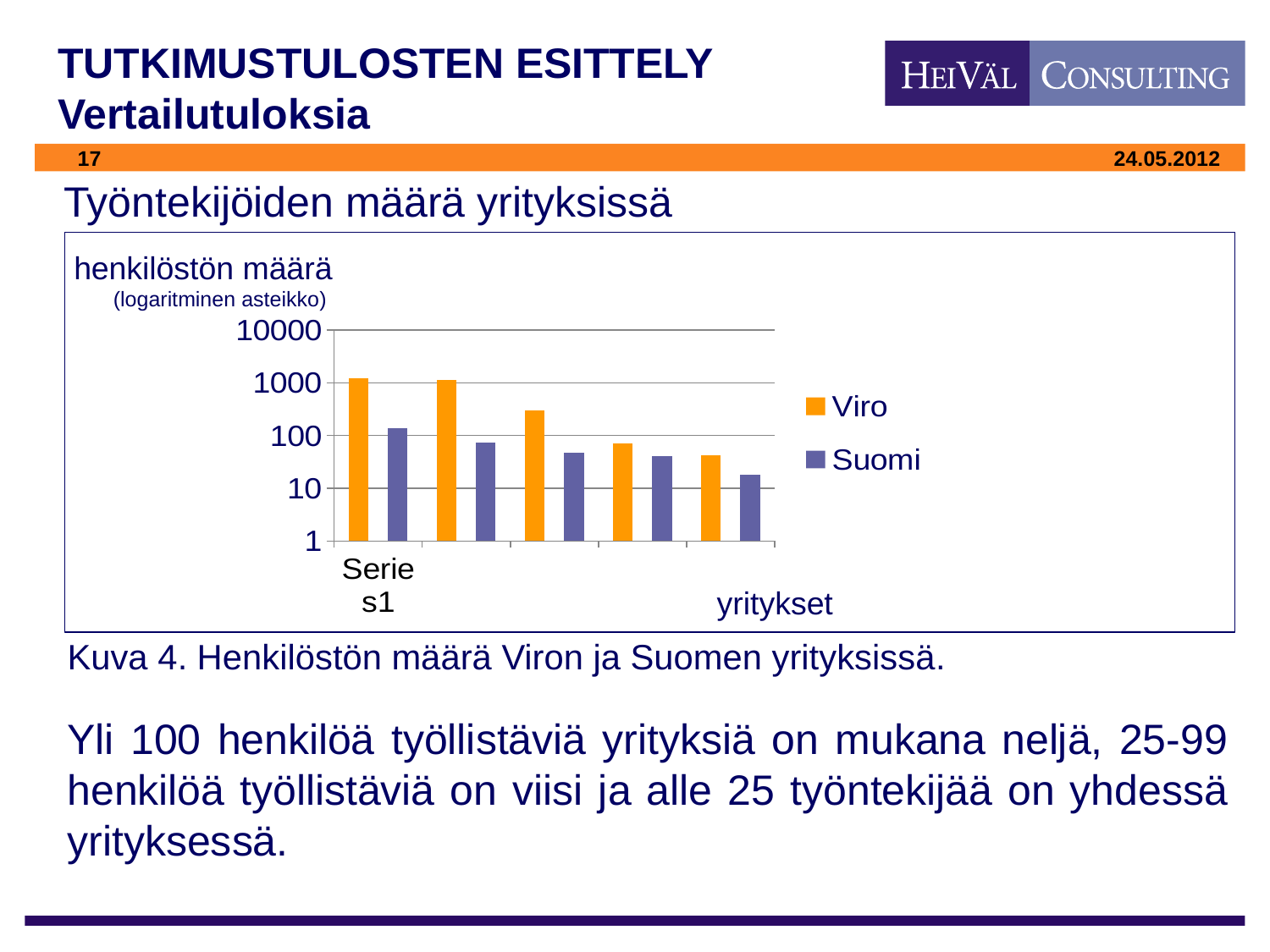
In the third group from the left, which series has the larger value, Viro or Suomi? Viro How many groups of bars (companies) are plotted on the x axis? 5 What colour are the Viro bars? orange Is the Viro value in the third group from the left greater or less than 100? greater Which series has the lowest bar in the chart, and in which group? Suomi, in the fifth (rightmost) group Is the Suomi value in the second group from the left greater or less than 100? less Which two series are listed in the legend? Viro and Suomi What kind of chart is shown on the slide? bar chart How many series does the legend list? 2 In the first group (Serie s1), which series has the larger value, Viro or Suomi? Viro Is the Suomi value in the fifth (rightmost) group greater or less than 100? less Do the Viro values rise or fall from left to right along the x axis? fall